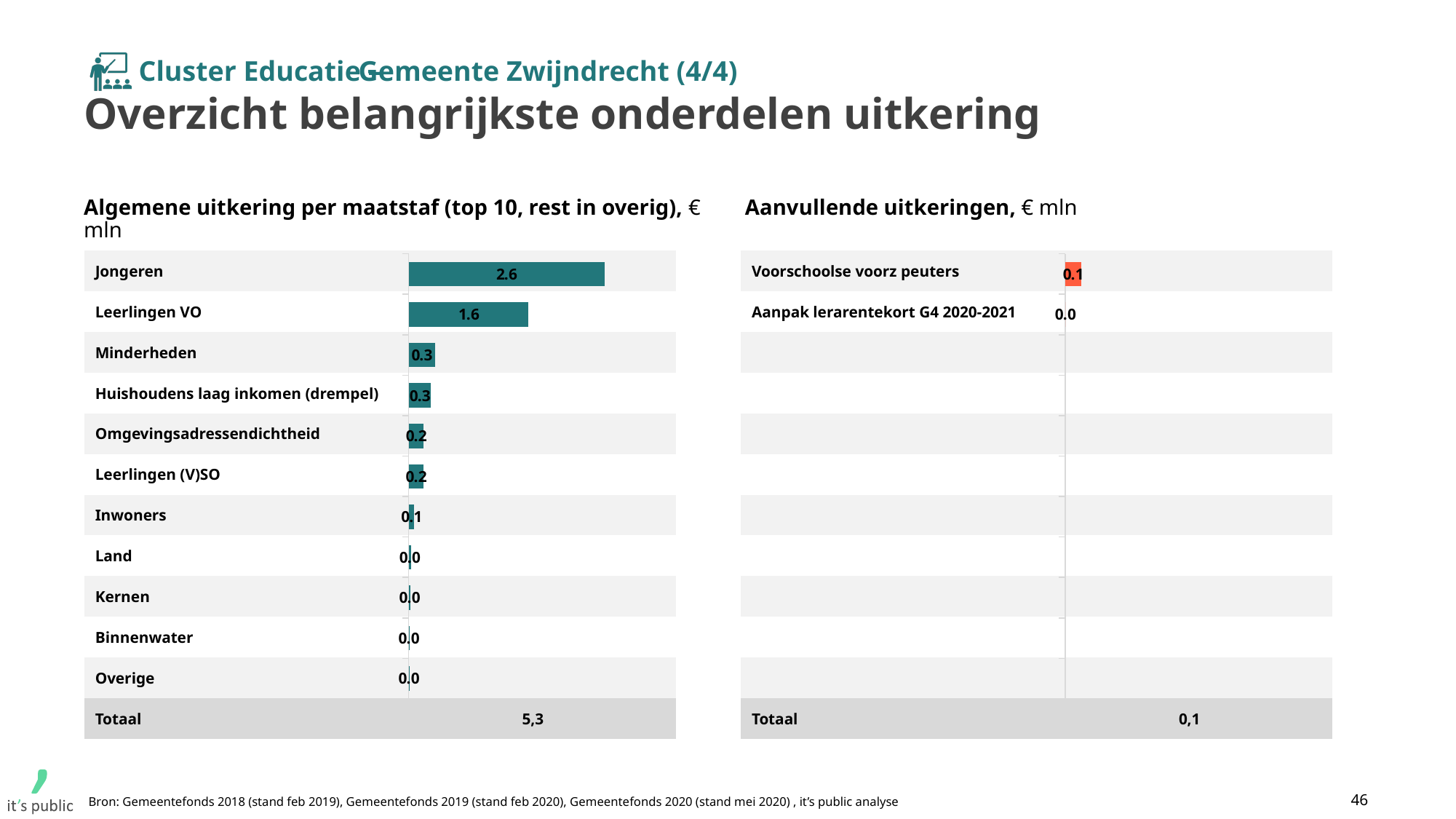
What is the Totaal shown for the chart 'Algemene uitkering per maatstaf'? 5,3 What unit is stated in the title of the chart 'Aanvullende uitkeringen'? € mln In the chart 'Aanvullende uitkeringen', what is the value for Voorschoolse voorz peuters? 0.1 How many categories (excluding the Totaal row) are shown in the chart 'Algemene uitkering per maatstaf'? 11 In the chart 'Algemene uitkering per maatstaf', what is the value for Minderheden? 0.3 What type of chart is the 'Aanvullende uitkeringen' chart? Bar chart In the chart 'Algemene uitkering per maatstaf', which category has the highest value? Jongeren In the chart 'Algemene uitkering per maatstaf', what is the difference between Jongeren and Leerlingen VO? 1.0 In the chart 'Aanvullende uitkeringen', what is the value for Aanpak lerarentekort G4 2020-2021? 0.0 In the chart 'Algemene uitkering per maatstaf', what is the value for Jongeren? 2.6 In the chart 'Algemene uitkering per maatstaf', which is larger: Leerlingen VO or Minderheden? Leerlingen VO In the chart 'Algemene uitkering per maatstaf', what is the value for Leerlingen VO? 1.6